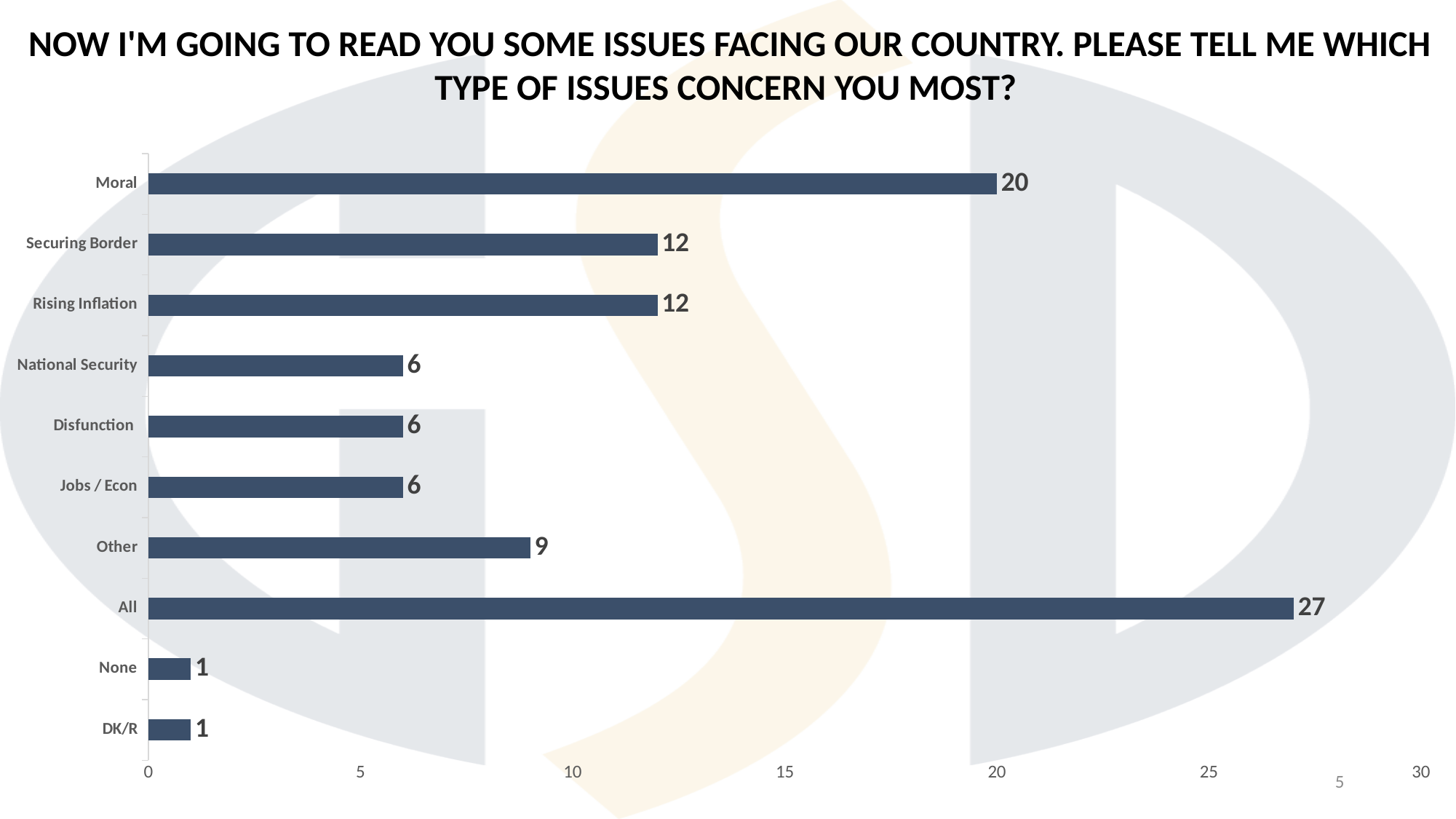
What is the value for Moral? 20 What is the value for Other? 9 Which category has the highest value? All What is the value for None? 1 What is the difference between the values for Securing Border and National Security? 6 Is the value for Moral greater or less than 15? greater What kind of chart is shown on the slide? bar chart What is the highest value shown on the x axis? 30 What is the difference between the values for All and Moral? 7 How many categories are shown in the chart? 10 Which is larger, the value for Rising Inflation or the value for Other? Rising Inflation What is the value for Securing Border? 12